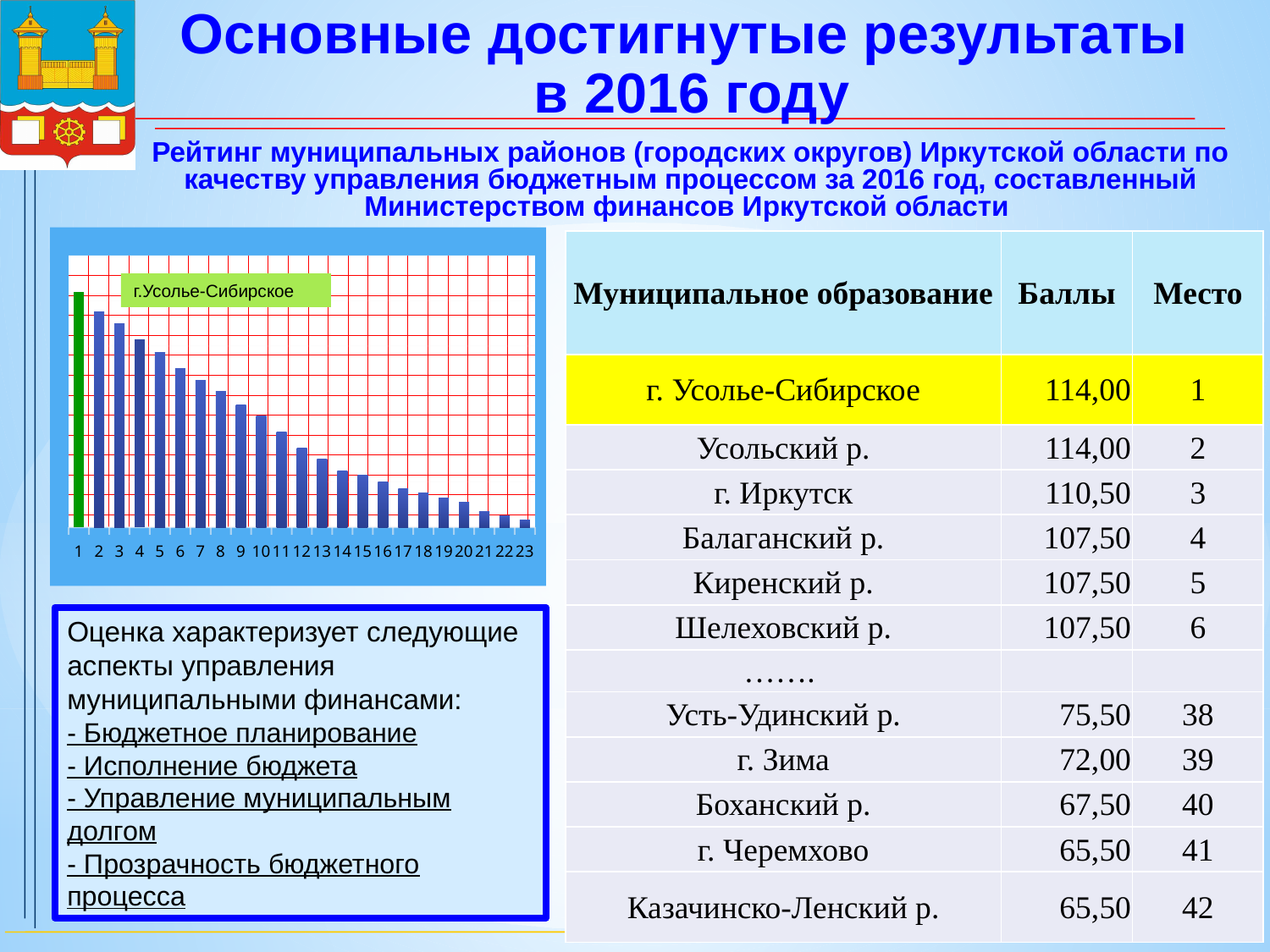
Which bar is taller, bar 2 or bar 20? bar 2 How many bars are plotted in the chart? 23 Which bar (by its x-axis number) is the tallest in the chart? 1 What kind of chart is shown on the slide? bar chart Do the bar values rise or fall moving from left to right along the x axis? fall What colour is the first bar in the chart, which differs from the other bars? green Which bar is taller, bar 10 or bar 5? bar 5 Which bar is shorter, bar 15 or bar 8? bar 15 Which bar (by its x-axis number) is the shortest in the chart? 23